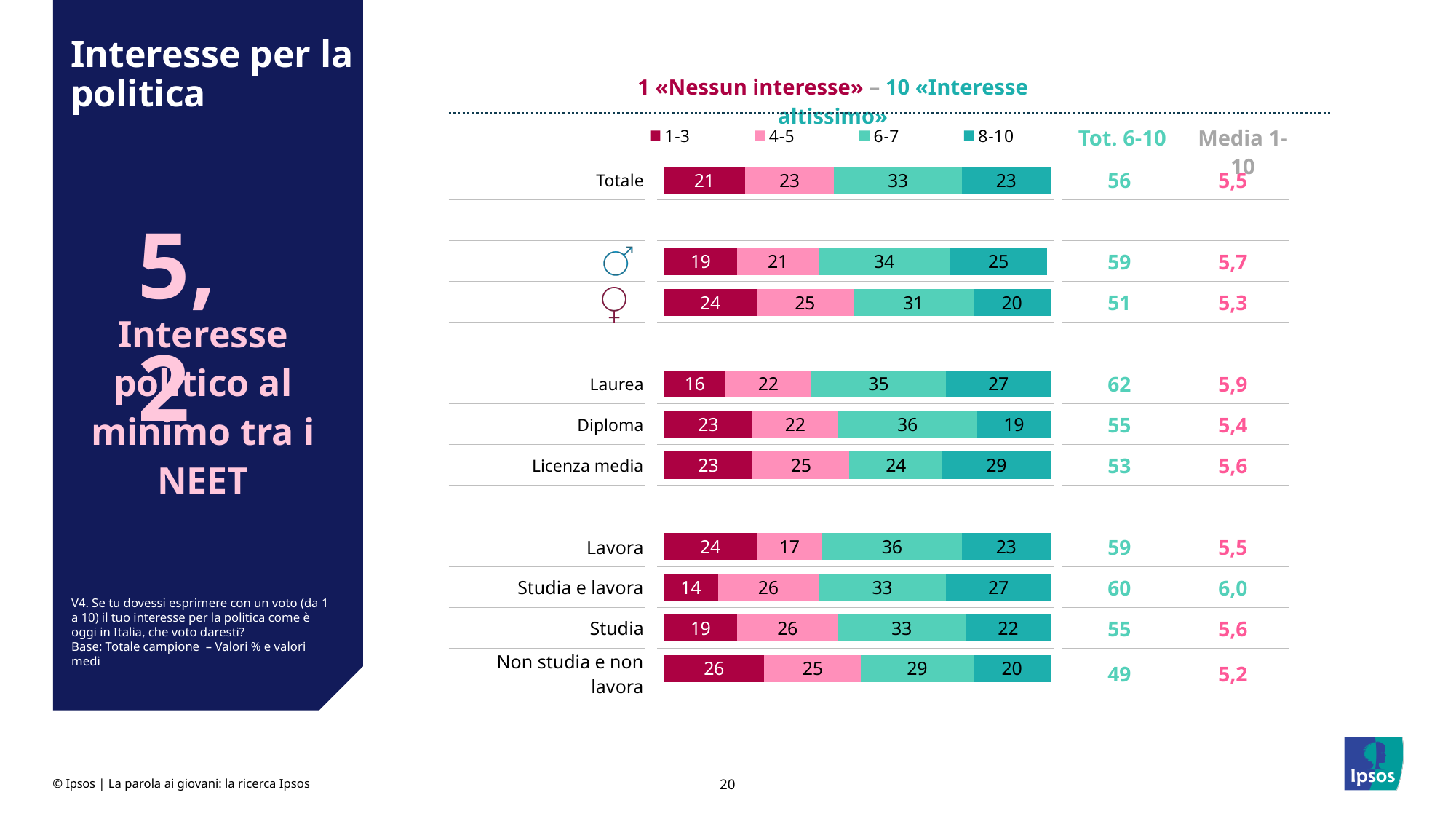
Which category has the lowest value in the 1-3 series? Studia e lavora Which category has the highest value in the 1-3 series? Non studia e non lavora What is the value of the 8-10 series for Licenza media? 29 What kind of chart is shown on the slide? Stacked bar chart What is the value of the 1-3 series for Laurea? 16 Which is larger, the 6-7 value for Lavora or the 6-7 value for Non studia e non lavora? Lavora What is the value of the 6-7 series for Diploma? 36 What is the difference between the 8-10 values for Laurea and Diploma? 8 What is the total of the stacked bar for Totale? 100 How many series does the chart legend list? 4 What is the value of the 4-5 series for Studia e lavora? 26 What is the Tot. 6-10 value shown for Non studia e non lavora? 49